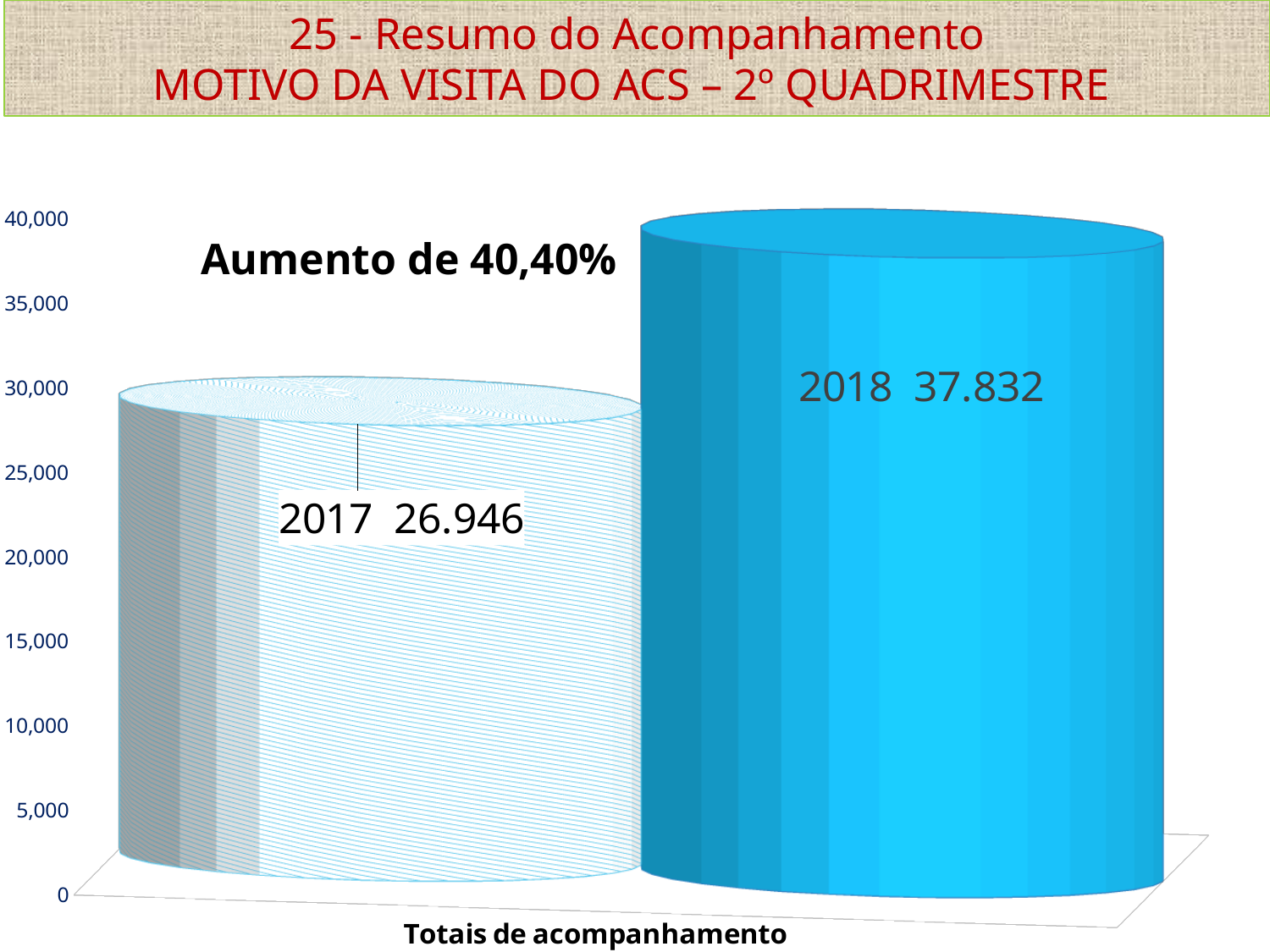
What is the value for 2017? 26.946 Which year has the higher value? 2018 Is the value for 2017 greater or less than 30,000? less Is the value for 2018 larger than the value for 2017? Yes Is the value for 2018 greater or less than 35,000? greater What is the value for 2018? 37.832 What is the label on the horizontal axis of the chart? Totais de acompanhamento How many bars are plotted in the chart? 2 What kind of chart is shown on the slide? Bar chart What percentage increase is stated on the chart? 40,40% What is the difference between the 2018 value and the 2017 value? 10.886 Which year has the lower value? 2017